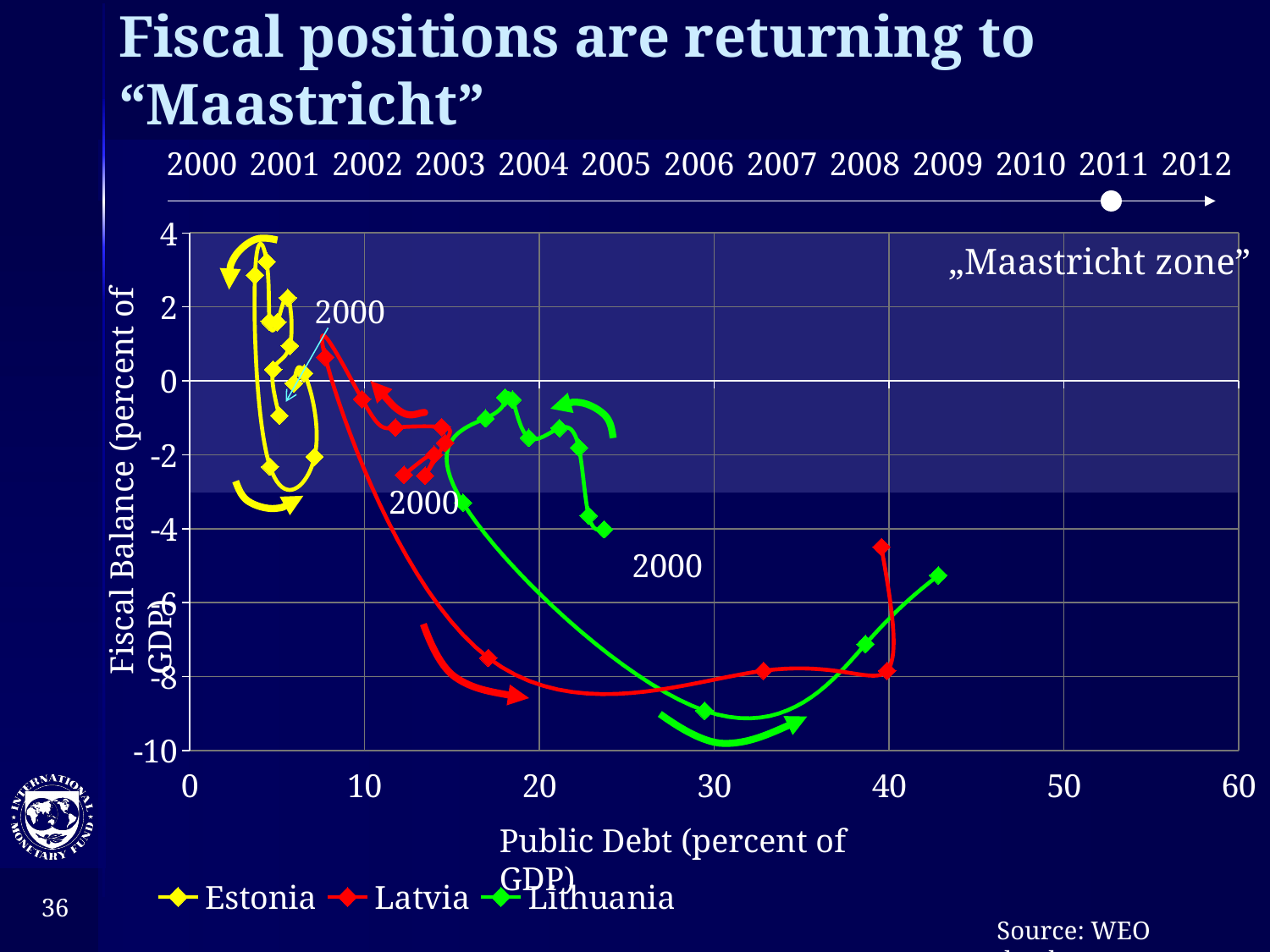
Is the highest public debt value for Estonia greater or less than 10? less Which series has a higher maximum public debt, Estonia or Latvia? Latvia Is the highest public debt value for Lithuania greater or less than 40? greater Is the highest fiscal balance for Estonia greater or less than 2? greater Which countries are listed in the chart legend? Estonia, Latvia, Lithuania How many series does the legend list? 3 Which series reaches the lowest fiscal balance on the chart? Lithuania What kind of chart is shown on the slide? scatter chart Which series reaches the highest public debt value on the chart? Lithuania Which series reaches the highest fiscal balance on the chart? Estonia What is the label of the horizontal axis? Public Debt (percent of GDP)